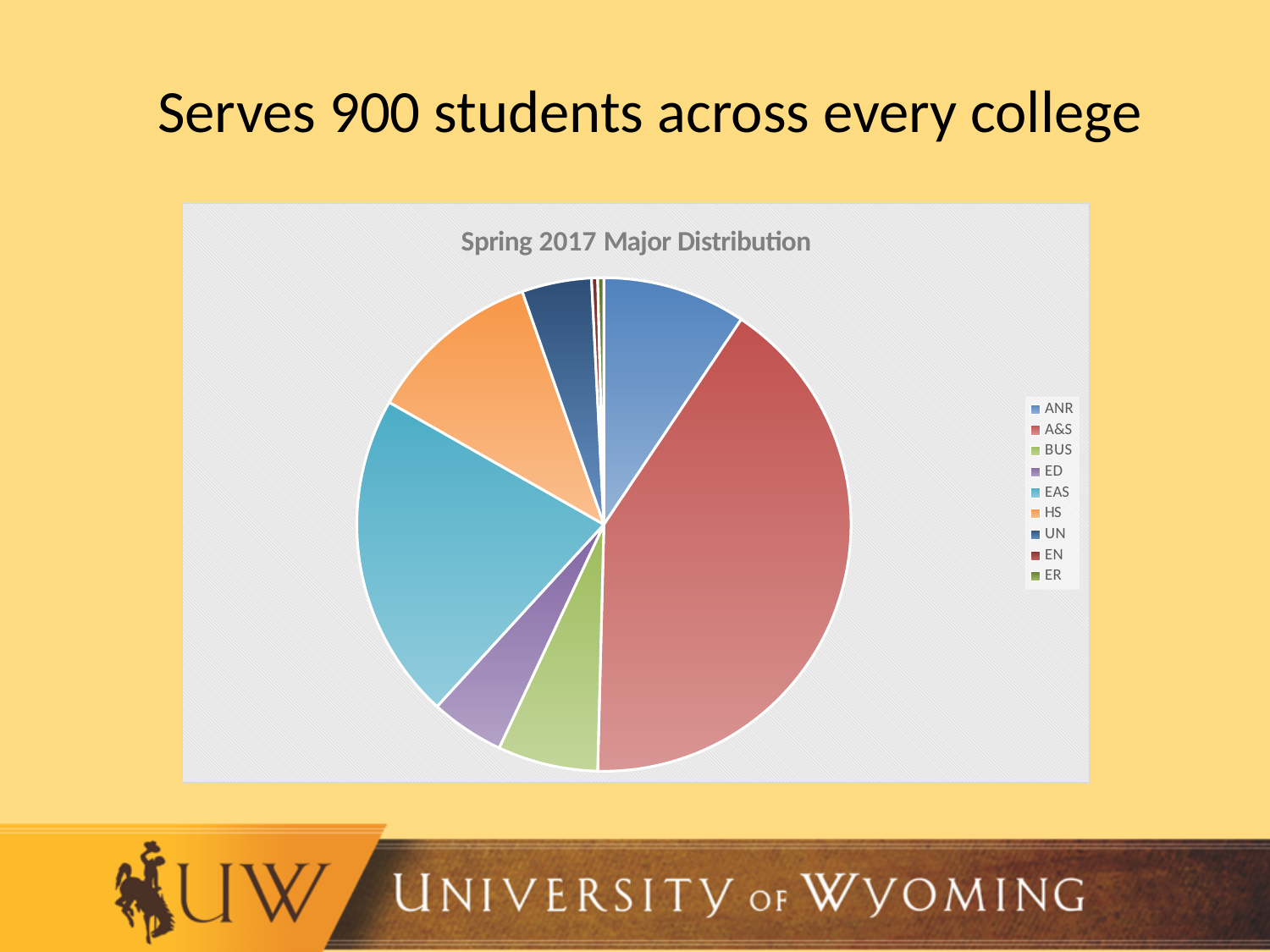
How many categories does the pie chart have? 9 Which category is listed first in the legend? ANR Which slice is larger, HS or UN? HS Which category is shown in light blue in the legend? EAS What is the title of the chart? Spring 2017 Major Distribution Which category has the largest slice of the pie? A&S Which slice is larger, EAS or ED? EAS Which slice is larger, A&S or EAS? A&S What kind of chart is shown on the slide? Pie chart